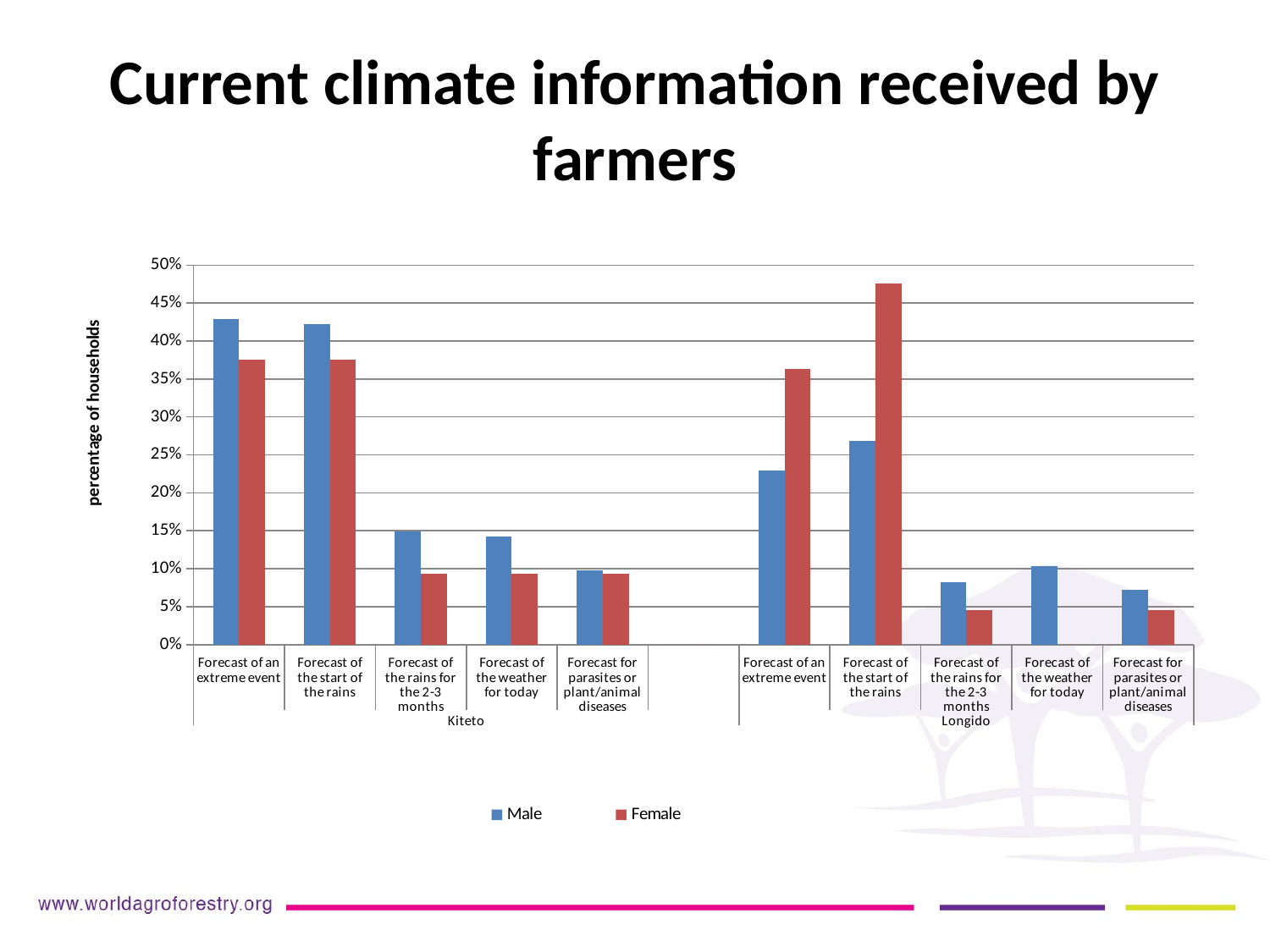
Which bar is the highest in the whole chart? Female, Forecast of the start of the rains (Longido) How many series does the legend list? 2 What kind of chart is shown on the slide? bar chart What is the label on the vertical axis? percentage of households Is the Male value for Forecast of an extreme event in Longido greater or less than 25%? less Is the Male value for Forecast of an extreme event in Kiteto greater or less than 40%? greater For Forecast of the start of the rains in Longido, which is larger, the Male or the Female value? Female For Forecast of an extreme event in Kiteto, which is larger, the Male or the Female value? Male Is the Female value for Forecast of the start of the rains in Longido greater or less than 45%? greater Among the Male bars in Kiteto, which category has the lowest value? Forecast for parasites or plant/animal diseases How many information categories are shown for each of the two locations? 5 What are the two series named in the legend? Male and Female